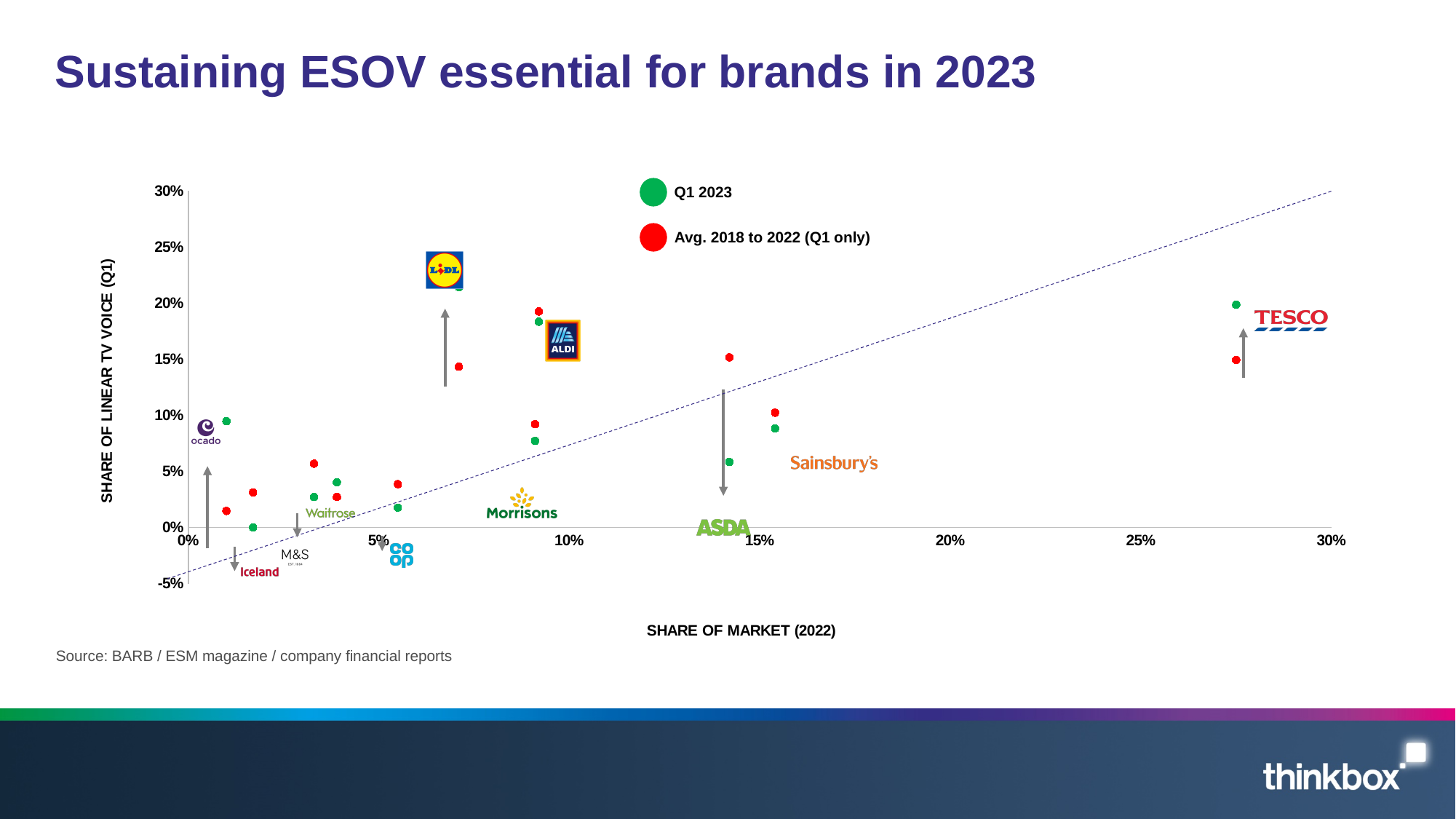
Is Tesco's share of market (2022) greater or less than 25%? greater Is Tesco's Q1 2023 share of linear TV voice greater or less than 15%? greater What are the two series named in the legend? Q1 2023 and Avg. 2018 to 2022 (Q1 only) What kind of chart is shown on the slide? Scatter chart For Asda, which is larger: the Q1 2023 share of voice or the Avg. 2018 to 2022 share of voice? Avg. 2018 to 2022 How many series does the legend list? 2 Which brand has the highest share of market (2022)? Tesco Did Lidl's share of linear TV voice rise or fall from the 2018-2022 average to Q1 2023? Rise What is the title of the horizontal axis? SHARE OF MARKET (2022) Is Asda's Q1 2023 share of linear TV voice greater or less than 10%? less Which brand has the highest Q1 2023 share of linear TV voice? Lidl How many brands are plotted on the chart? 11